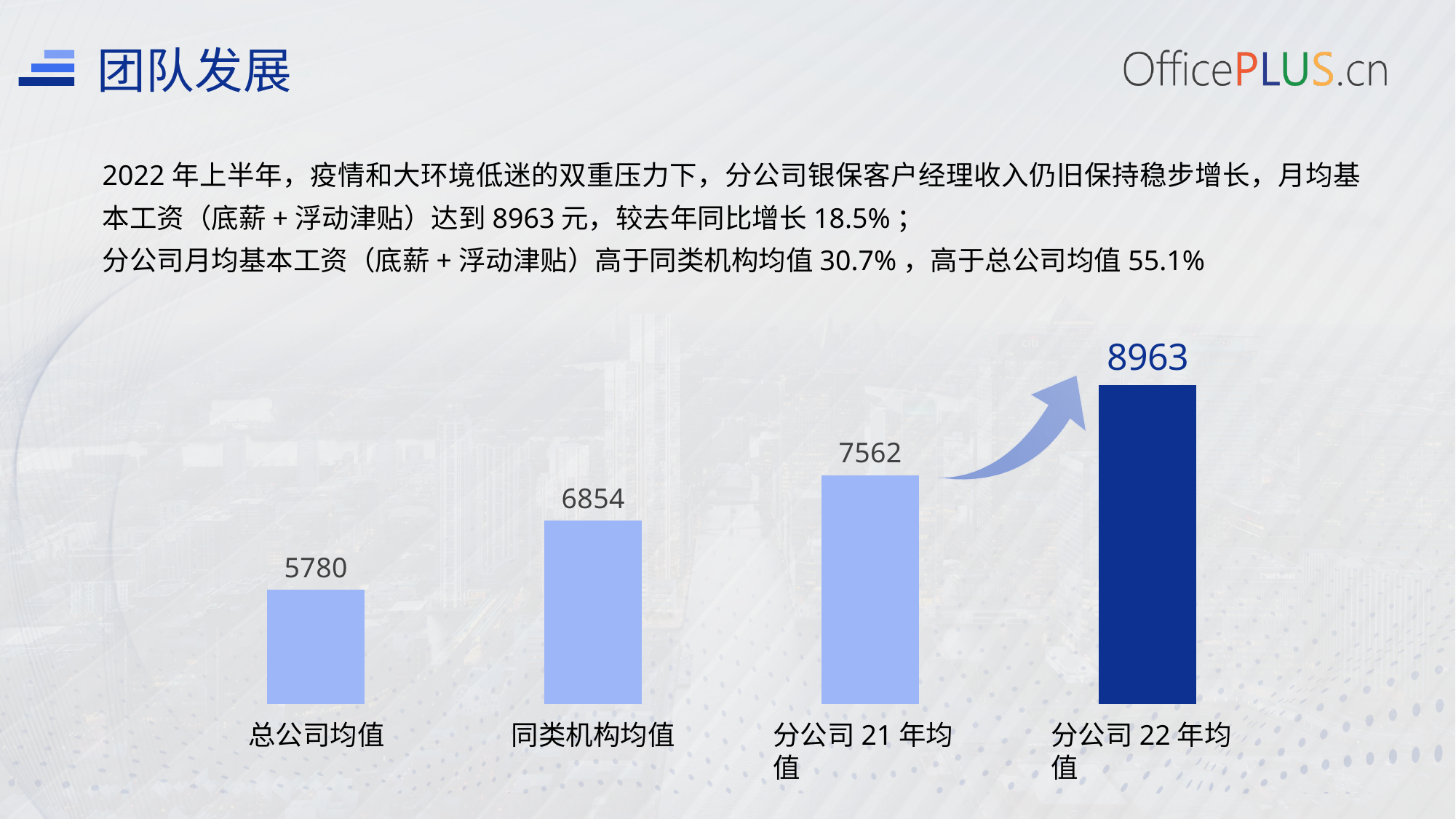
What is the value for 同类机构均值? 6854 Which category has the lowest value? 总公司均值 What kind of chart is shown on the slide? Bar chart What is the value for 总公司均值? 5780 Do the values rise or fall from left to right across the categories? Rise Which is larger, the value for 同类机构均值 or the value for 分公司 21 年均值? 分公司 21 年均值 What is the value for 分公司 21 年均值? 7562 How many categories are shown in the chart? 4 What is the difference between the values for 分公司 22 年均值 and 分公司 21 年均值? 1401 Which category has the highest value? 分公司 22 年均值 What is the difference between the values for 同类机构均值 and 总公司均值? 1074 What is the value for 分公司 22 年均值? 8963